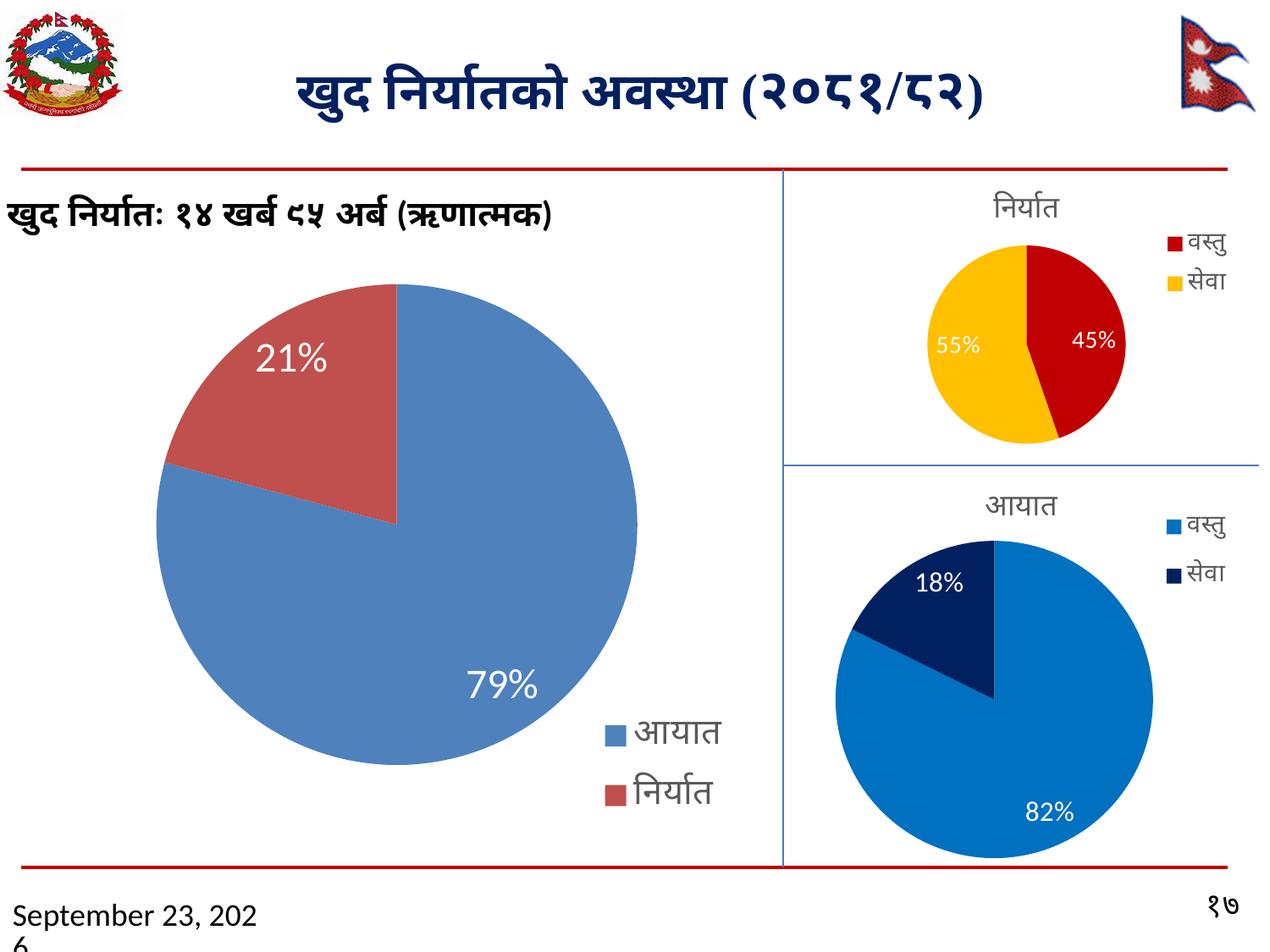
In the pie chart titled निर्यात, what share does वस्तु have? 45% In the large pie chart on the left, what share does निर्यात have? 21% What kind of chart is the large chart on the left of the slide? Pie chart In the large pie chart on the left, what share does आयात have? 79% In the large pie chart on the left, which category has the larger slice? आयात How many entries does the legend of the pie chart titled आयात list? 2 In the large pie chart on the left, what is the difference between the आयात and निर्यात shares? 58% In the pie chart titled निर्यात, which category has the larger slice? सेवा In the pie chart titled आयात, which category has the smaller slice? सेवा